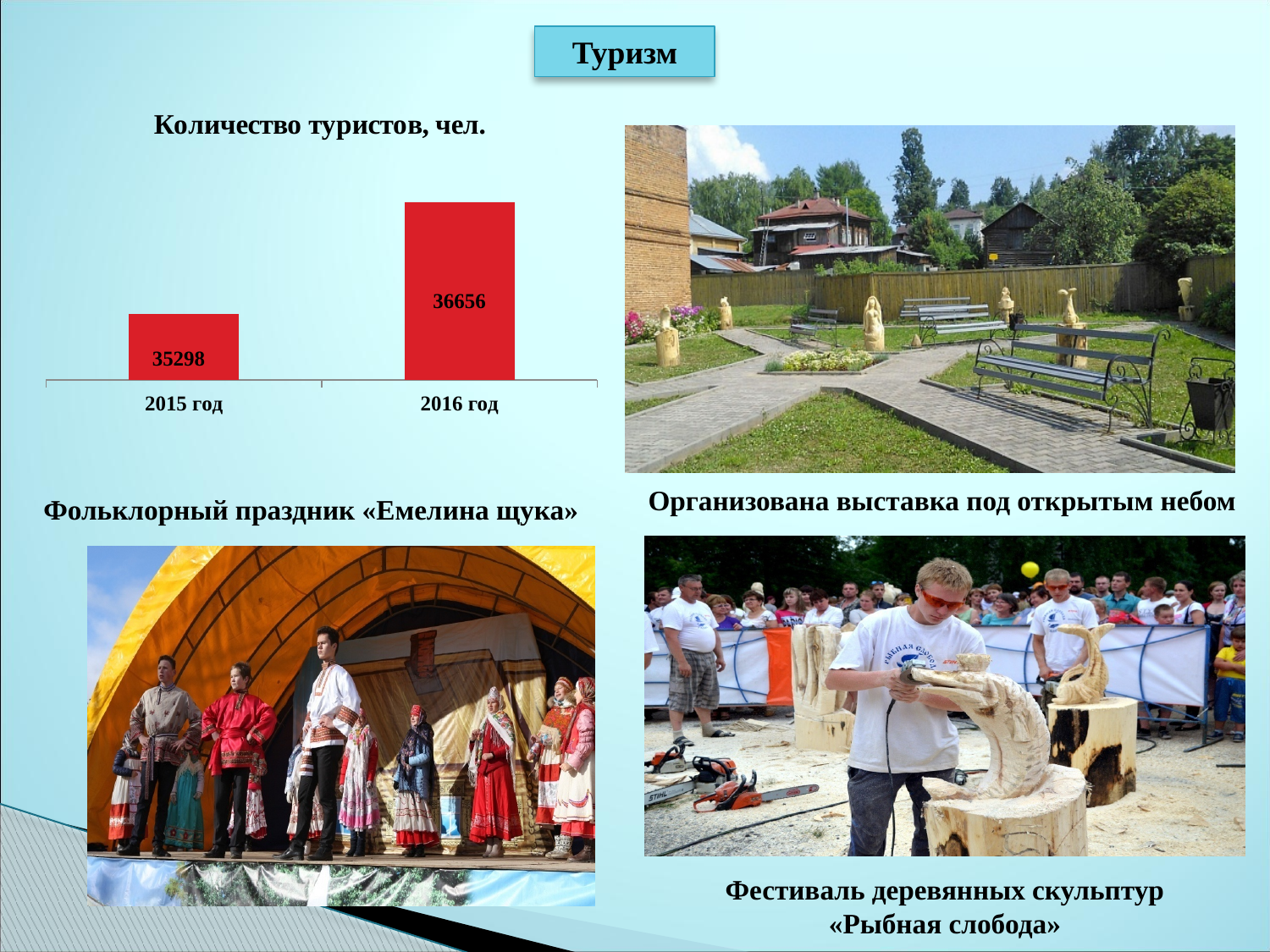
Does the number of tourists rise or fall from 2015 год to 2016 год? rise By how much did the number of tourists in 2016 год exceed that in 2015 год? 1358 What colour are the bars in the chart? red Is the value for 2015 год larger or smaller than the value for 2016 год? smaller Which year has the lower number of tourists? 2015 год What kind of chart is used to show the number of tourists? bar chart What is the number of tourists shown for 2016 год? 36656 What is the number of tourists shown for 2015 год? 35298 What is the title of the chart? Количество туристов, чел. Which year has the higher number of tourists? 2016 год How many categories (years) are shown on the chart? 2